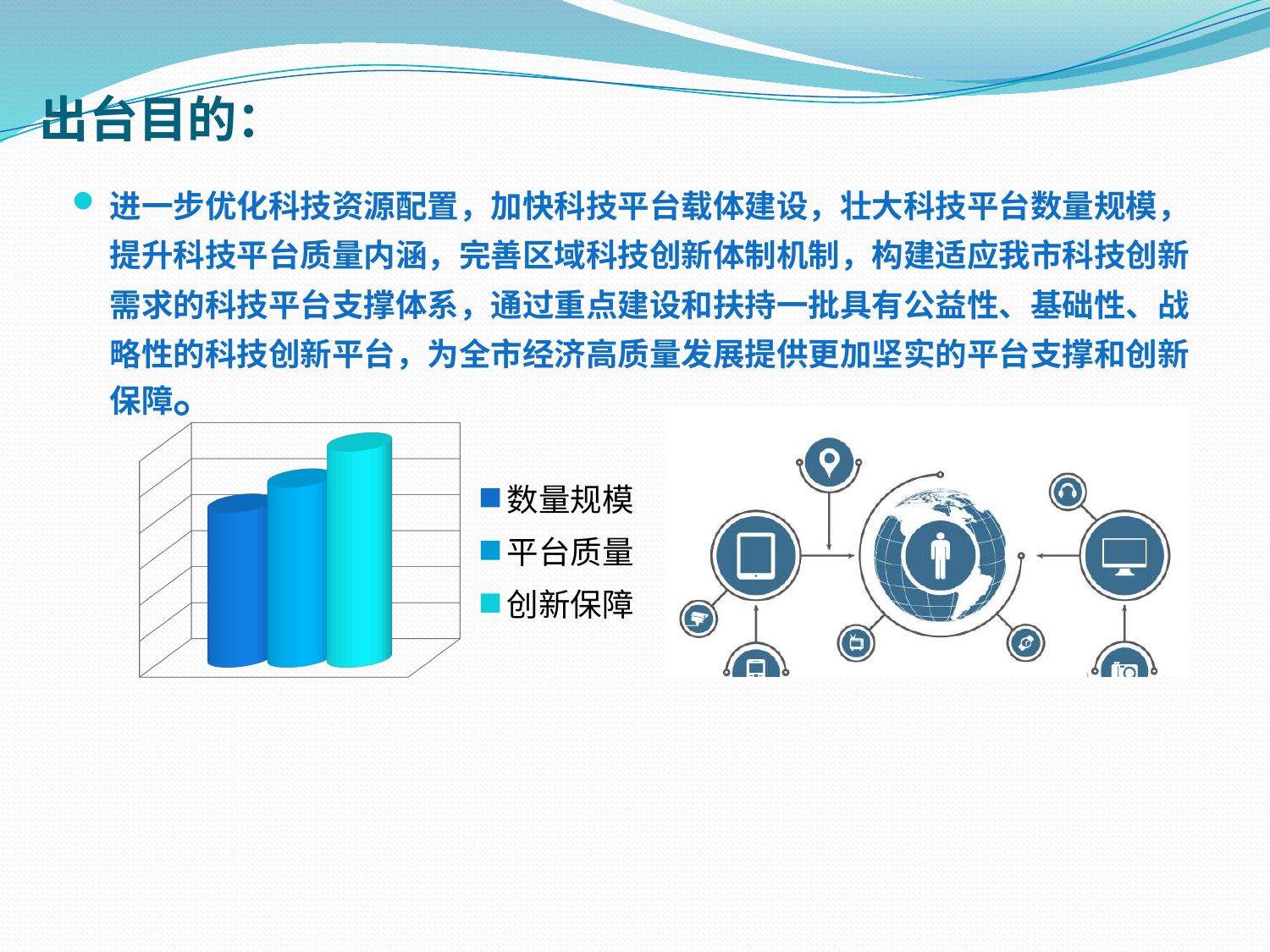
Which series has the shortest bar in the chart? 数量规模 Which series has the tallest bar in the chart? 创新保障 What is the third entry listed in the chart legend? 创新保障 What kind of chart is shown on the slide? bar chart Which bar is taller, 平台质量 or 数量规模? 平台质量 How many bars are plotted in the chart? 3 Which legend entry is shown in the darkest blue colour? 数量规模 Do the bar heights rise or fall from left to right across the chart? rise Which bar is taller, 创新保障 or 平台质量? 创新保障 How many series does the chart legend list? 3